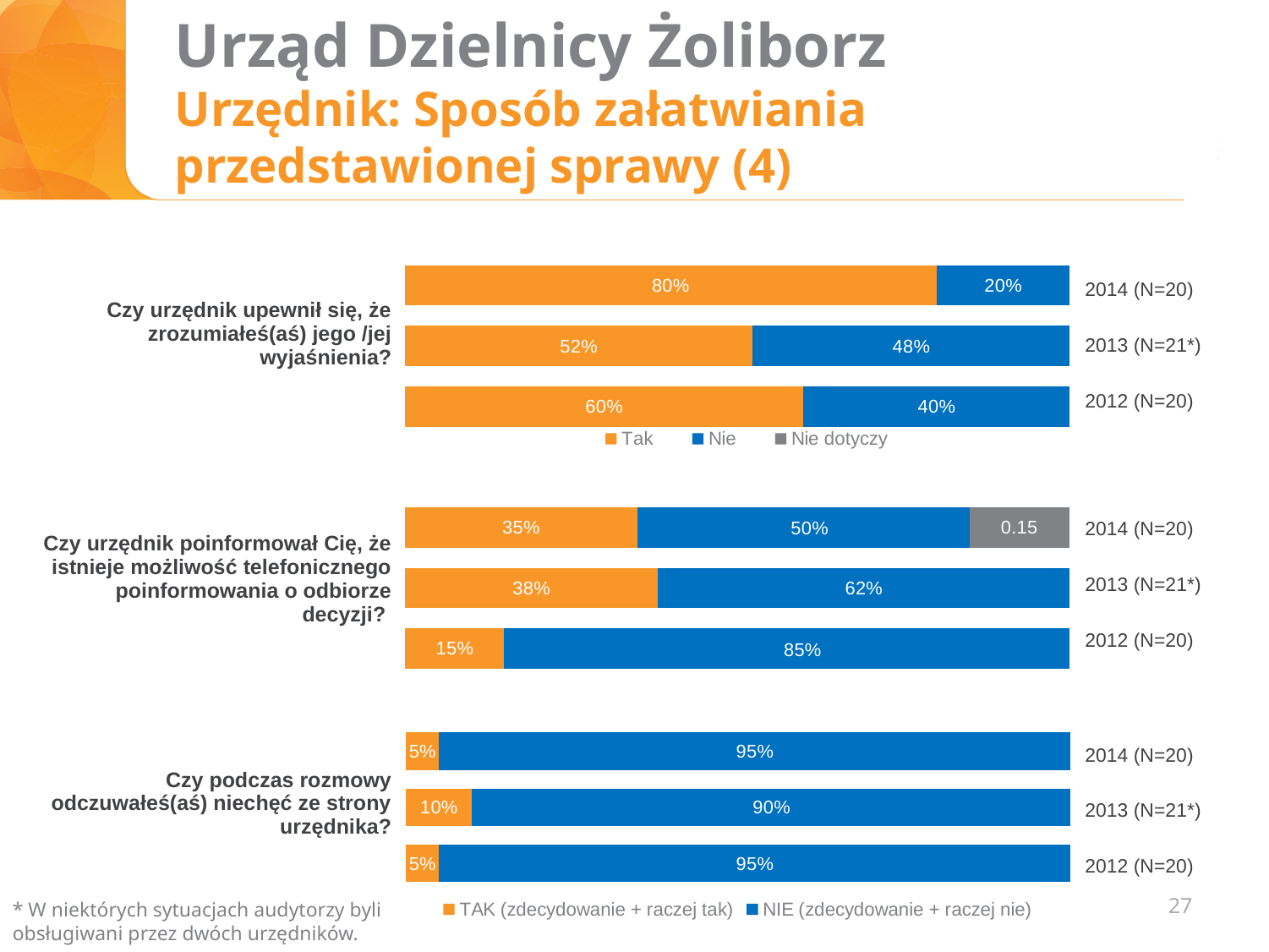
In the chart for 'Czy urzędnik poinformował Cię, że istnieje możliwość telefonicznego poinformowania o odbiorze decyzji?', what is the 'Nie dotyczy' value for 2014 (N=20)? 0.15 How many legend entries does the chart for 'Czy urzędnik upewnił się, że zrozumiałeś(aś) jego /jej wyjaśnienia?' list? 3 In the chart for 'Czy urzędnik upewnił się, że zrozumiałeś(aś) jego /jej wyjaśnienia?', what is the difference between the 'Tak' values for 2014 and 2012? 20% In the chart for 'Czy urzędnik upewnił się, że zrozumiałeś(aś) jego /jej wyjaśnienia?', which year has the highest 'Tak' value? 2014 (N=20) In the chart for 'Czy urzędnik upewnił się, że zrozumiałeś(aś) jego /jej wyjaśnienia?', what is the 'Nie' value for 2013 (N=21*)? 48% In the chart for 'Czy podczas rozmowy odczuwałeś(aś) niechęć ze strony urzędnika?', which year has the highest 'TAK' value? 2013 (N=21*) In the chart for 'Czy podczas rozmowy odczuwałeś(aś) niechęć ze strony urzędnika?', what is the 'NIE' value for 2013 (N=21*)? 90% In the chart for 'Czy urzędnik poinformował Cię, że istnieje możliwość telefonicznego poinformowania o odbiorze decyzji?', which year has the lowest 'Tak' value? 2012 (N=20) In the chart for 'Czy urzędnik poinformował Cię, że istnieje możliwość telefonicznego poinformowania o odbiorze decyzji?', is the 'Tak' value larger for 2013 or for 2012? 2013 What kind of chart is used for 'Czy podczas rozmowy odczuwałeś(aś) niechęć ze strony urzędnika?'? Stacked bar chart In the chart for 'Czy urzędnik poinformował Cię, że istnieje możliwość telefonicznego poinformowania o odbiorze decyzji?', what is the 'Nie' value for 2012 (N=20)? 85% In the chart for 'Czy urzędnik upewnił się, że zrozumiałeś(aś) jego /jej wyjaśnienia?', what is the 'Tak' value for 2014 (N=20)? 80%